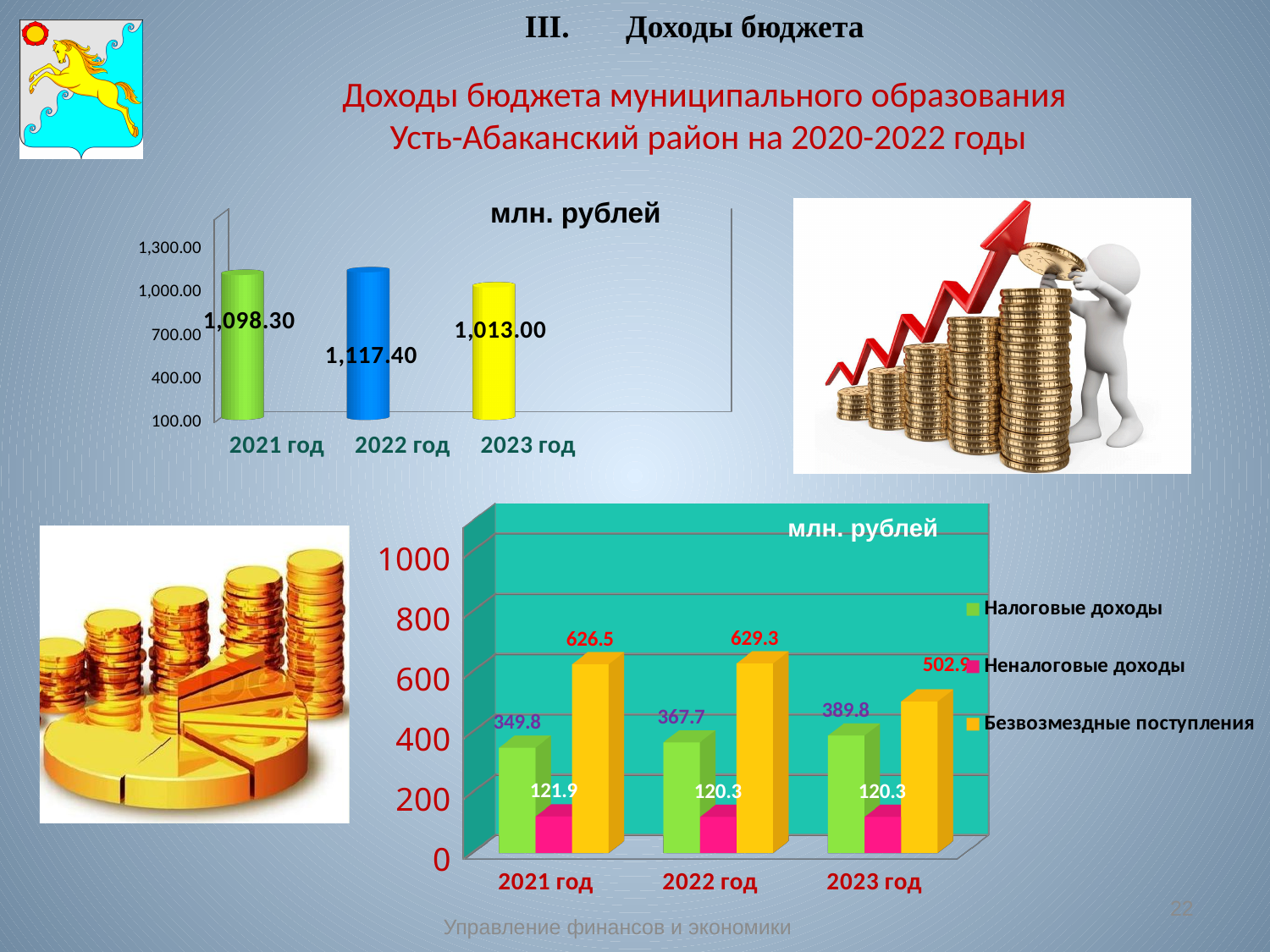
In the top-left bar chart, which year has the lowest value? 2023 год In the bottom chart, what is the value of Налоговые доходы for 2023 год? 389.8 In the top-left bar chart, what is the value for 2022 год? 1,117.40 In the top-left bar chart, how many years are shown? 3 In the bottom chart, what is the value of Безвозмездные поступления for 2022 год? 629.3 In the bottom chart, how many series does the legend list? 3 In the bottom chart, what is the value of Неналоговые доходы for 2021 год? 121.9 In the bottom chart, which is larger for 2023 год: Налоговые доходы or Безвозмездные поступления? Безвозмездные поступления In the top-left bar chart, what is the difference between the values for 2022 год and 2023 год? 104.40 In the bottom chart, do the values of Налоговые доходы rise or fall from 2021 год to 2023 год? rise What kind of chart is the bottom chart? bar chart In the top-left bar chart, which year has the highest value? 2022 год